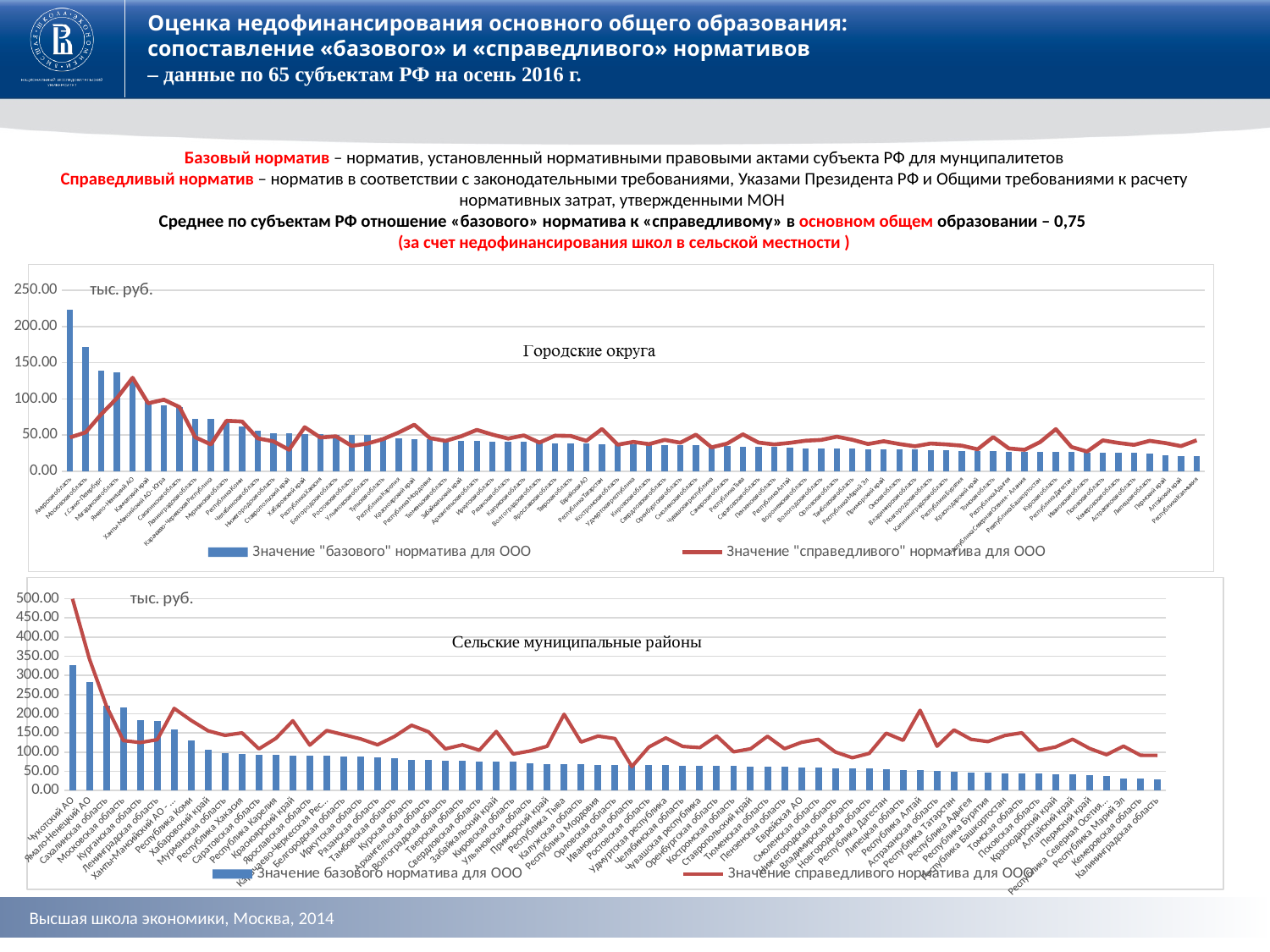
In the bottom chart "Сельские муниципальные районы", is the bar value for Ямало-Ненецкий АО greater or less than 250? greater In the bottom chart "Сельские муниципальные районы", which series is drawn as a red line? Значение справедливого норматива для ООО In the bottom chart "Сельские муниципальные районы", is the bar value for Чукотский АО greater or less than 300? greater In the top chart "Городские округа", do the bar values generally rise or fall from left to right along the x axis? fall In the top chart "Городские округа", is the value of the first (leftmost) bar greater or less than 200? greater How many series does the legend of the bottom chart "Сельские муниципальные районы" list? 2 In the bottom chart "Сельские муниципальные районы", do the bar values generally rise or fall from left to right? fall In the bottom chart "Сельские муниципальные районы", which category has the highest bar? Чукотский АО In the top chart "Городские округа", what is the unit label shown near the top of the y axis? тыс. руб. What kind of chart is the top chart titled "Городские округа"? Bar chart with a line series